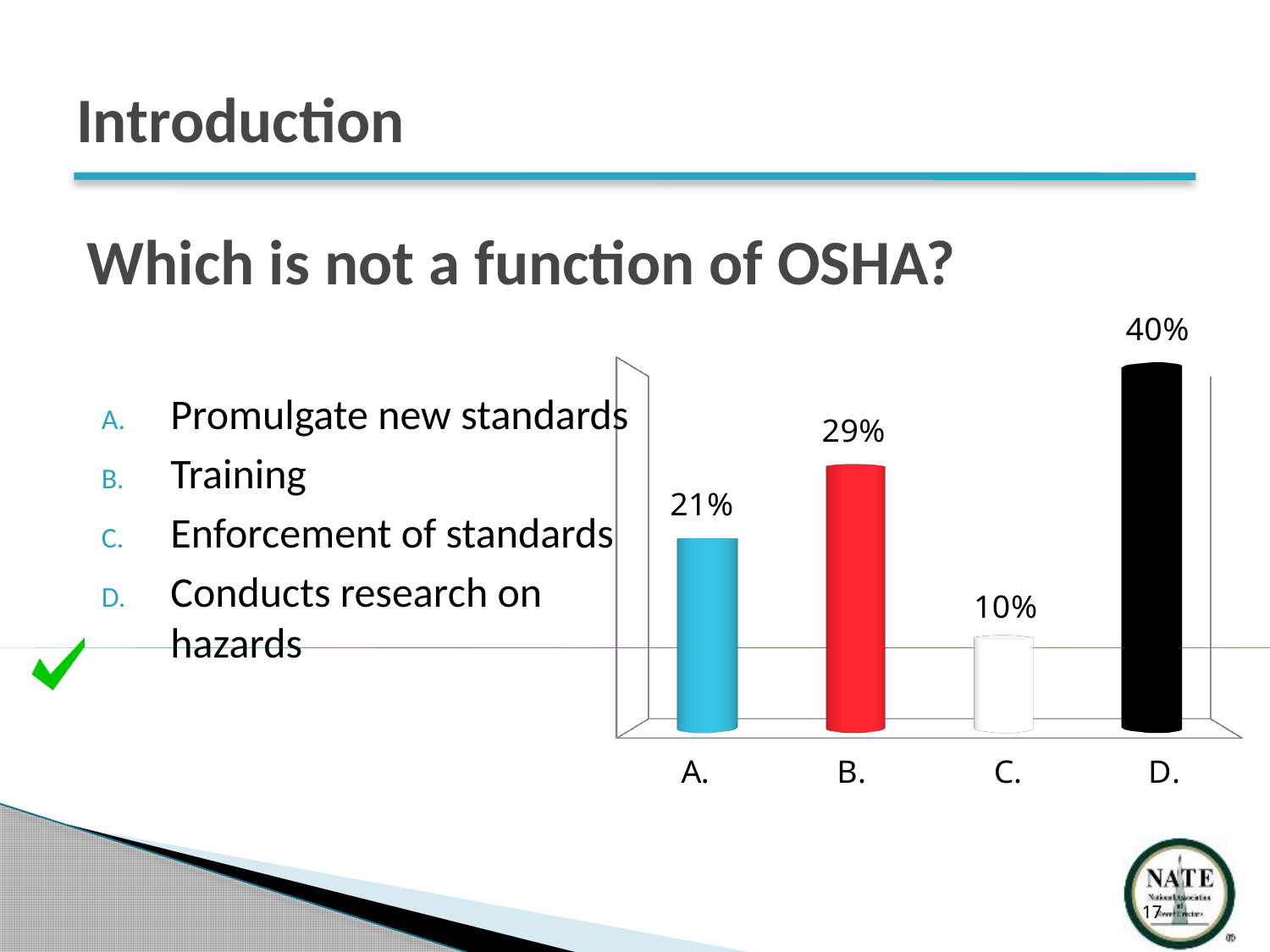
What is the value for category A. in the bar chart? 21% What is the difference between the values for D. and A. in the bar chart? 19% How many categories are shown in the bar chart? 4 Which is larger in the bar chart, the value for A. or the value for B.? B. Which category has the highest value in the bar chart? D. What is the value for category C. in the bar chart? 10% What kind of chart is shown on the slide? bar chart Which category has the lowest value in the bar chart? C. What is the difference between the values for B. and C. in the bar chart? 19% What is the value for category B. in the bar chart? 29% What colour is the bar for category B. in the chart? red What is the value for category D. in the bar chart? 40%